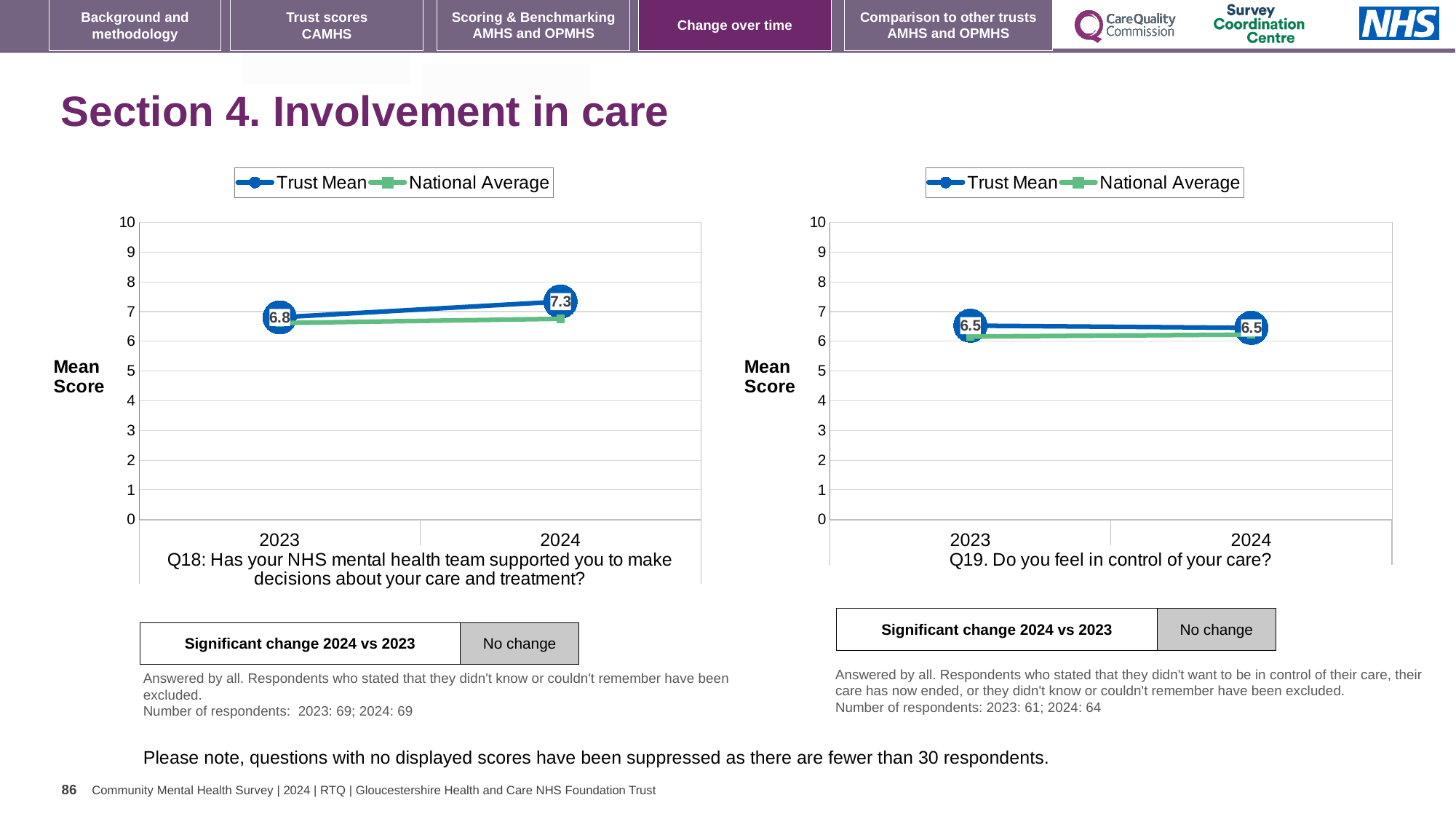
In the Q18 chart, by how much did the Trust Mean change from 2023 to 2024? 0.5 In the Q19 chart, which year has the higher Trust Mean, 2023 or 2024? They are equal (6.5) In the Q19 chart, is the National Average for 2023 greater or less than 7? less In the Q18 chart, what is the Trust Mean score for 2023? 6.8 In the Q19 chart, what is the Trust Mean score for 2023? 6.5 In the Q18 chart, is the Trust Mean for 2024 higher or lower than the National Average for 2024? higher How many series does the legend of the Q18 chart list? 2 In the Q18 chart, what is the Trust Mean score for 2024? 7.3 What is the y-axis label on the Q18 chart? Mean Score In the Q18 chart, does the Trust Mean rise or fall from 2023 to 2024? rise What type of chart is used for Q19? line chart How many years are plotted on the x axis of the Q19 chart? 2